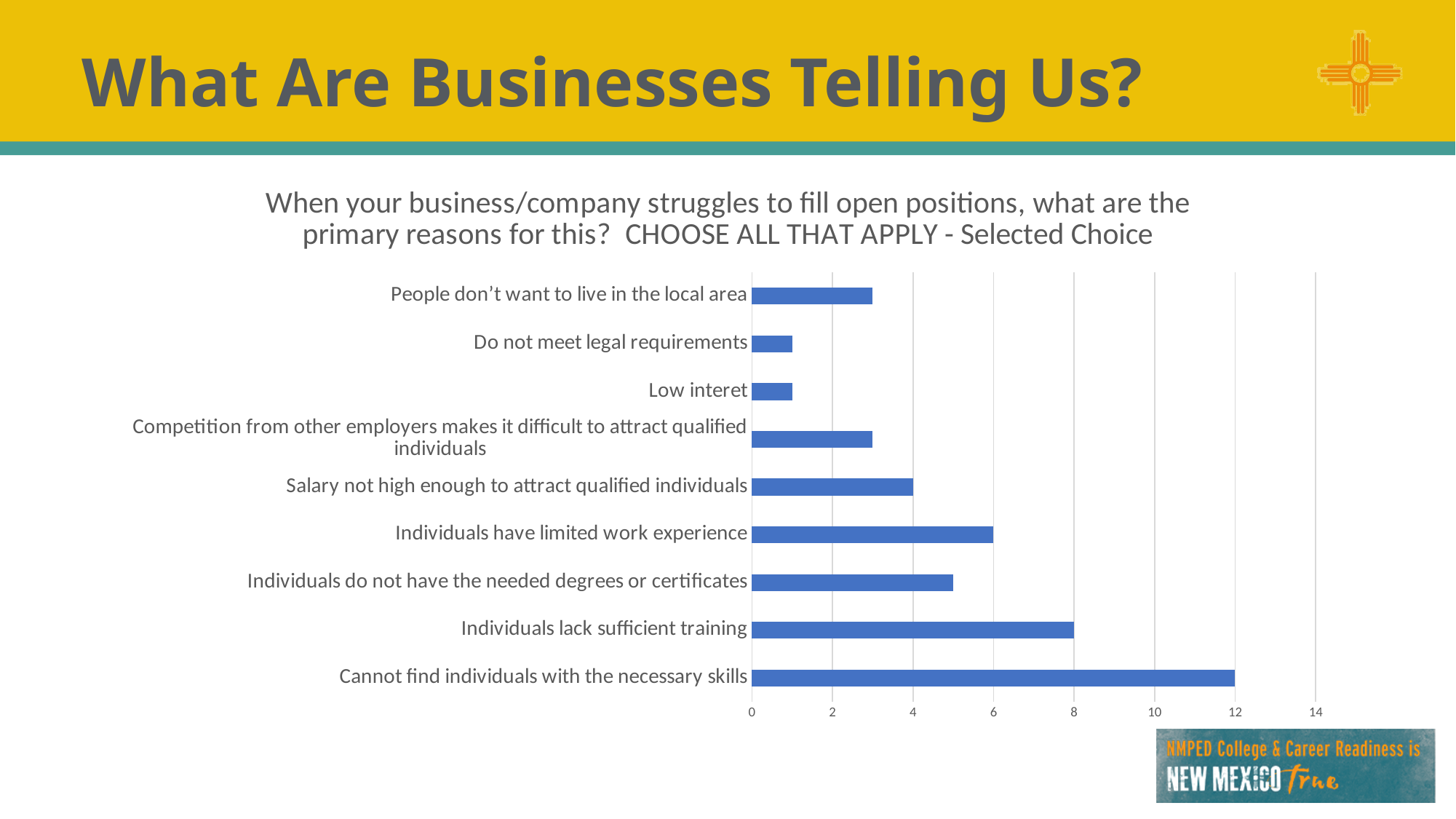
Is the value for "Do not meet legal requirements" greater or less than 2? less What is the difference between the values for "Cannot find individuals with the necessary skills" and "Individuals lack sufficient training"? 4 How many reasons (categories) are plotted in the chart? 9 What is the highest value shown on the horizontal axis of the chart? 14 Which reason has the highest value in the chart? Cannot find individuals with the necessary skills What is the value for "Individuals lack sufficient training"? 8 What is the value for "Salary not high enough to attract qualified individuals"? 4 What is the value for "Individuals have limited work experience"? 6 What kind of chart is shown on the slide? bar chart What is the value for "Cannot find individuals with the necessary skills"? 12 Which is larger: the value for "Individuals have limited work experience" or the value for "Salary not high enough to attract qualified individuals"? Individuals have limited work experience Is the value for "People don't want to live in the local area" greater or less than 2? greater